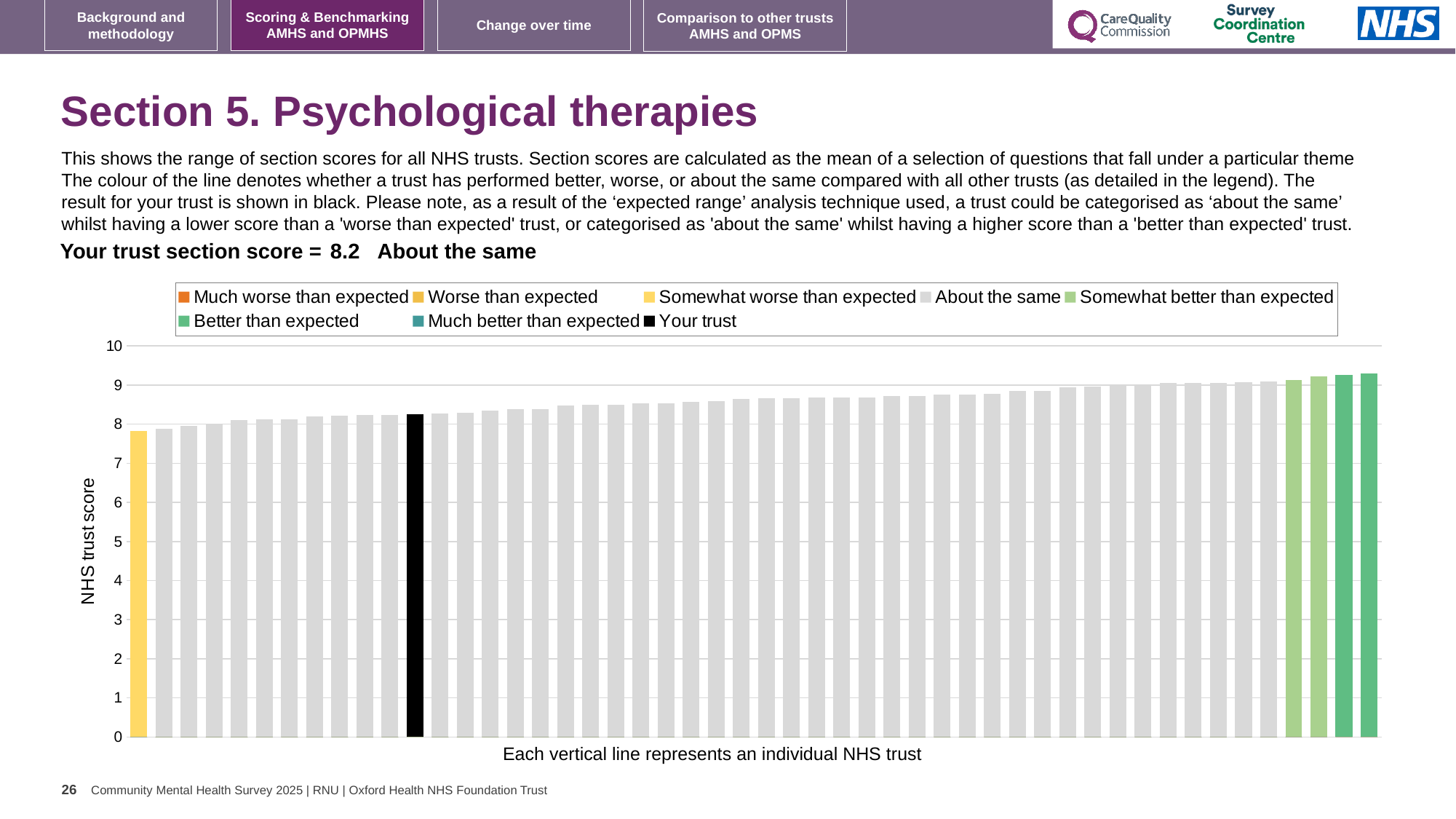
Is the value for the black 'Your trust' bar greater or less than 9? less Which benchmarking category is your trust placed in for this section? About the same What does each vertical line on the chart represent, according to the x-axis label? an individual NHS trust Is the value for the black 'Your trust' bar greater or less than 8? greater Is the value for the leftmost (yellow) bar greater or less than 8? less What is the label on the vertical axis of the chart? NHS trust score What is the section score for your trust shown on the slide? 8.2 What kind of chart is shown on the slide? bar chart Do the bar values rise or fall moving from left to right along the x axis? rise How many entries does the chart legend list? 8 How many bars on the chart are coloured black? 1